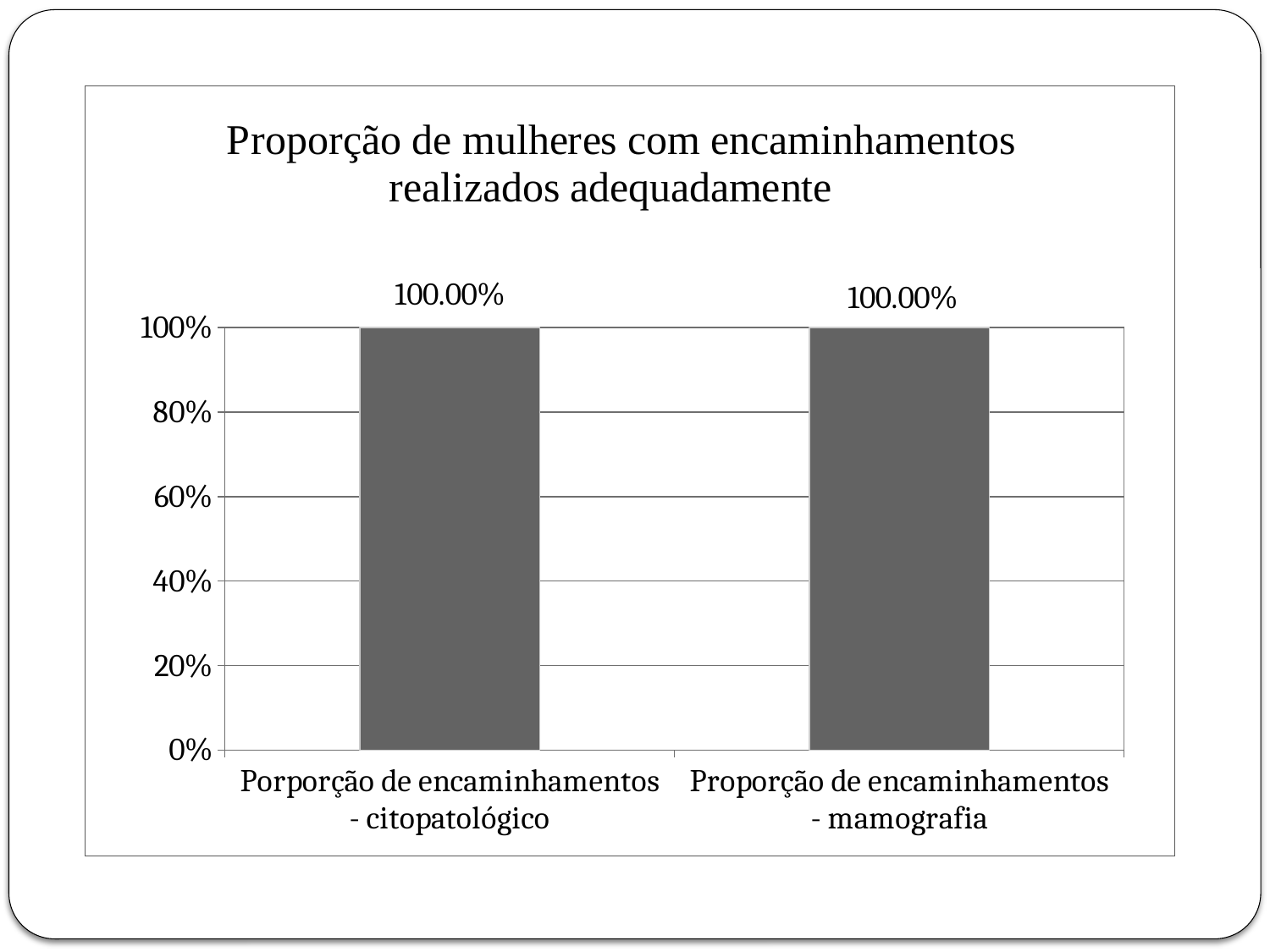
What is the value for 'Proporção de encaminhamentos - mamografia'? 100.00% Is the value for 'Proporção de encaminhamentos - mamografia' greater or less than 80%? greater How many categories are shown on the x axis? 2 What is the title of the chart? Proporção de mulheres com encaminhamentos realizados adequadamente What kind of chart is shown on the slide? Bar chart What is the highest value shown on the y axis? 100% What is the value for 'Porporção de encaminhamentos - citopatológico'? 100.00% What is the difference between the values for citopatológico and mamografia? 0.00% Is the value for 'Porporção de encaminhamentos - citopatológico' greater or less than 60%? greater Do the two bars have the same value? Yes